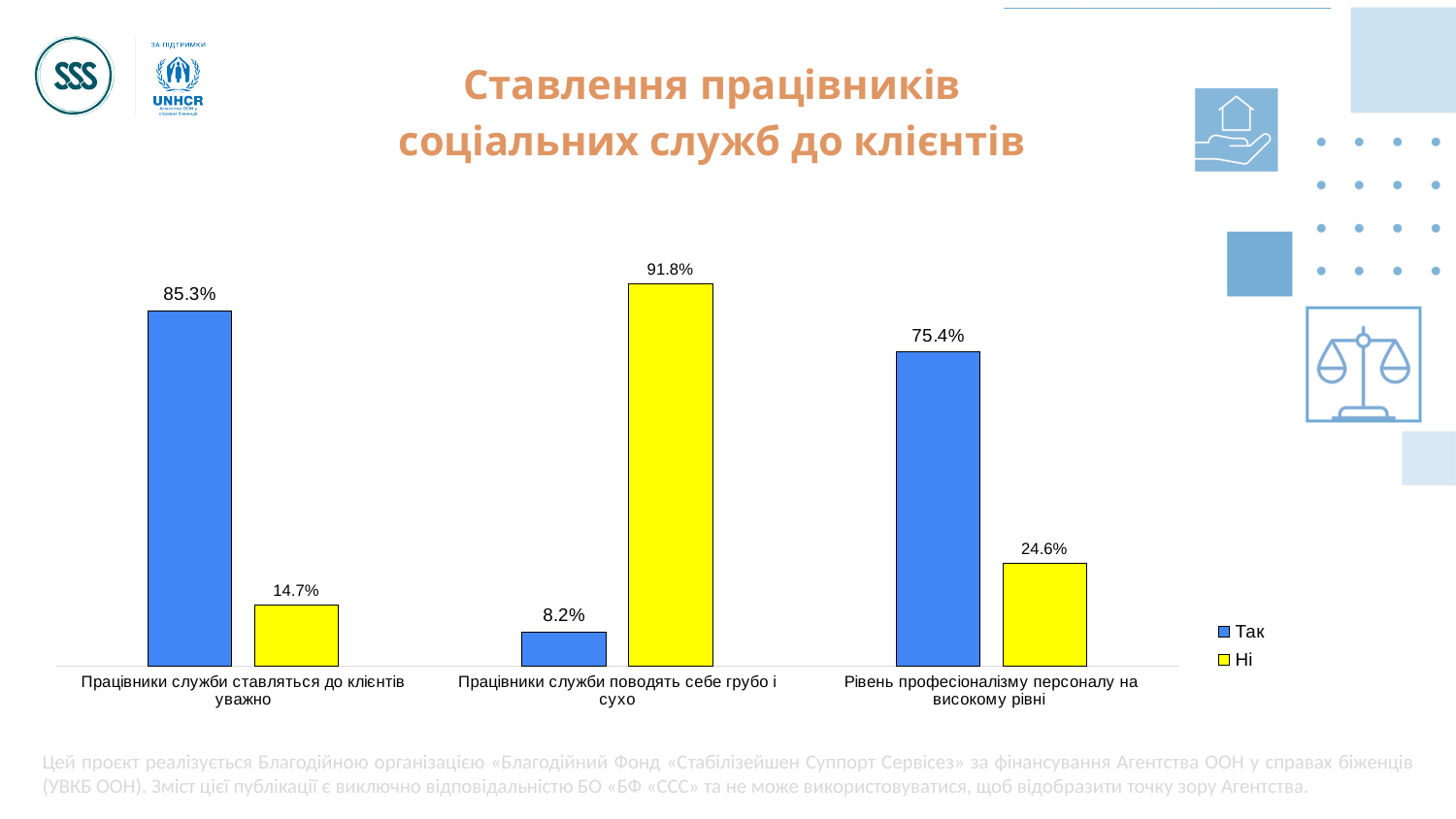
What type of chart is shown on the slide? Bar chart What is the value for "Так" in the category "Рівень професіоналізму персоналу на високому рівні"? 75.4% What is the value for "Ні" in the category "Працівники служби поводять себе грубо і сухо"? 91.8% What is the value for "Ні" in the category "Рівень професіоналізму персоналу на високому рівні"? 24.6% Which category has the highest value for the "Так" series? Працівники служби ставляться до клієнтів уважно How many series does the chart legend list? 2 What is the value for "Так" in the category "Працівники служби ставляться до клієнтів уважно"? 85.3% How many categories are shown on the x axis of the chart? 3 Which category has the lowest value for the "Ні" series? Працівники служби ставляться до клієнтів уважно What colour are the bars for the "Ні" series? Yellow What is the difference between the "Так" and "Ні" values in the category "Працівники служби ставляться до клієнтів уважно"? 70.6% In the category "Працівники служби поводять себе грубо і сухо", which is larger, "Так" or "Ні"? Ні